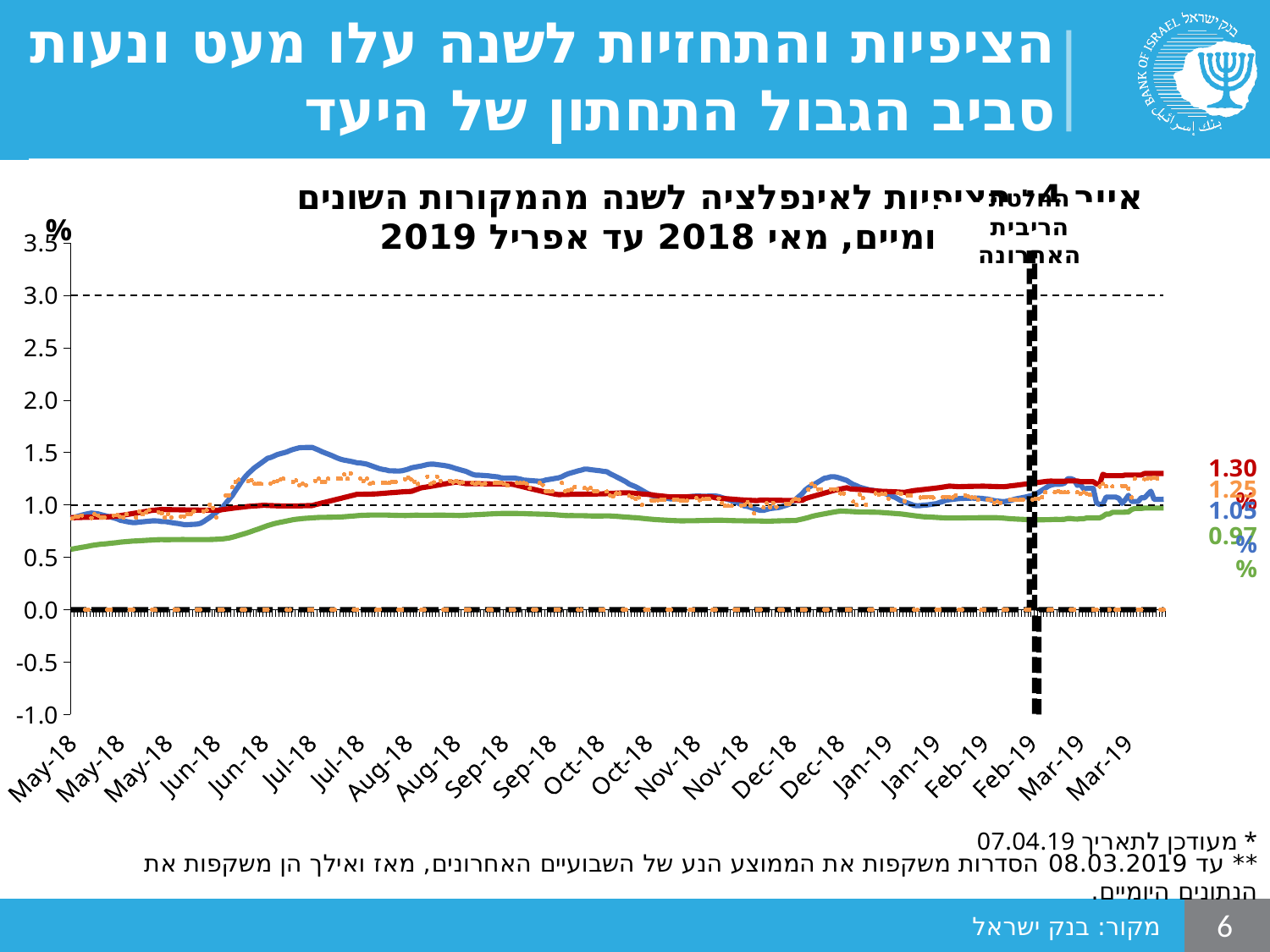
What kind of chart is shown on the slide? Line chart Does the green line rise or fall overall from May-18 to Mar-19? Rises What is the difference between the red line's end value (1.30%) and the orange line's end value (1.25%)? 0.05 percentage points What is the lowest end-of-period value labelled at the right of the chart? 0.97% What is the difference between the highest (1.30%) and lowest (0.97%) end values labelled on the chart? 0.33 percentage points Is the blue line's peak value in Jul-18 greater or less than 2.0? less What is the highest end-of-period value labelled at the right of the chart? 1.30% Is the green line's value in Jun-18 greater or less than 1.0? less Which has the larger end value, the red line or the green line? The red line What is the end value labelled for the blue line? 1.05% What is the end value labelled for the orange dotted line? 1.25%